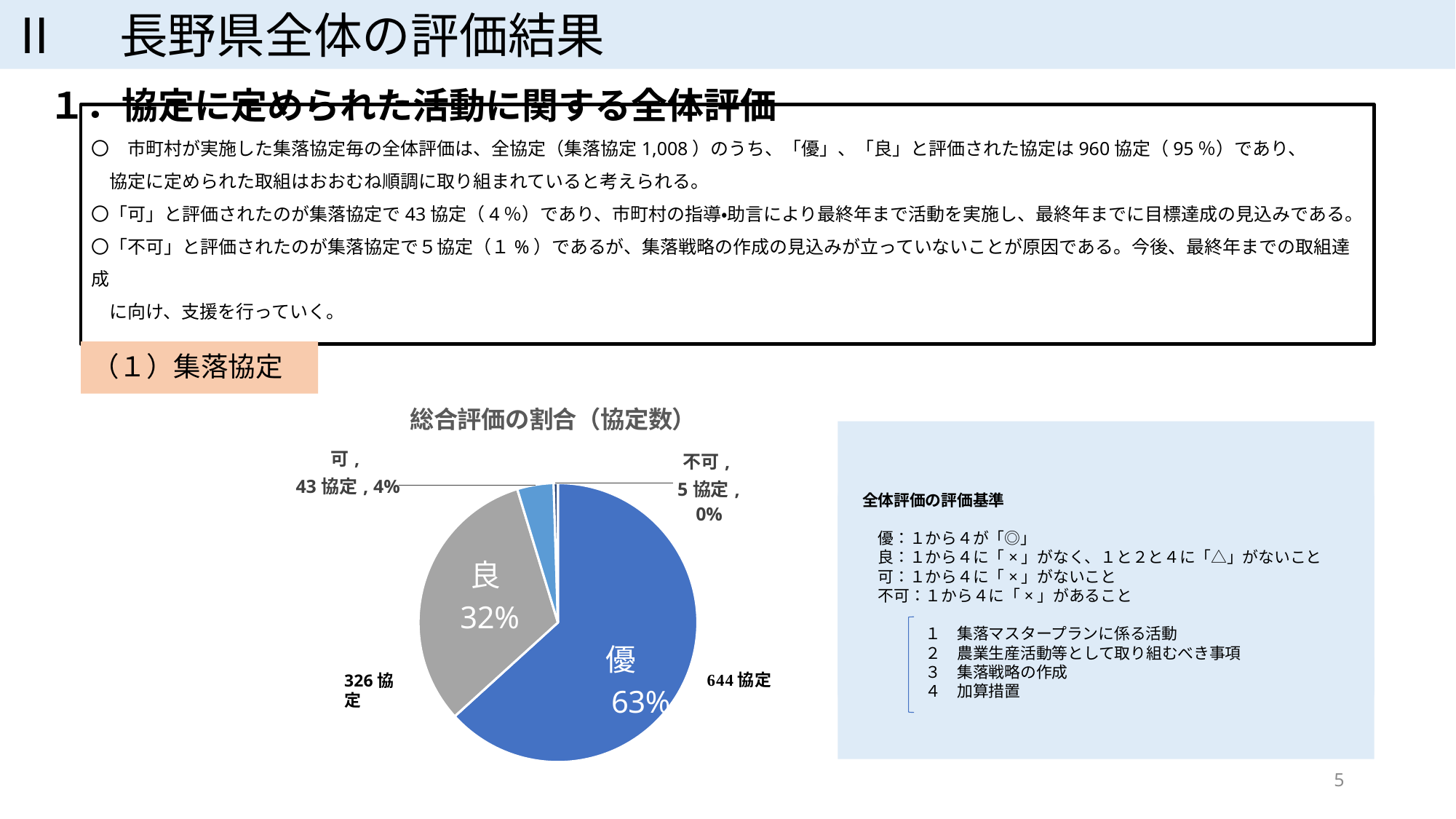
What share of the pie does the 優 slice represent? 63% What is the title of the pie chart? 総合評価の割合（協定数） Which category has the largest slice in the pie chart? 優 Which category has the smallest slice in the pie chart? 不可 What is the difference in 協定 count between the 優 and 良 slices? 318 How many 協定 are in the 可 slice of the pie chart? 43 協定 How many 協定 are in the 優 slice of the pie chart? 644 協定 How many 協定 are in the 不可 slice of the pie chart? 5 協定 How many 協定 are in the 良 slice of the pie chart? 326 協定 How many slices does the pie chart have? 4 What type of chart is shown on the slide? pie chart What share of the pie does the 良 slice represent? 32%